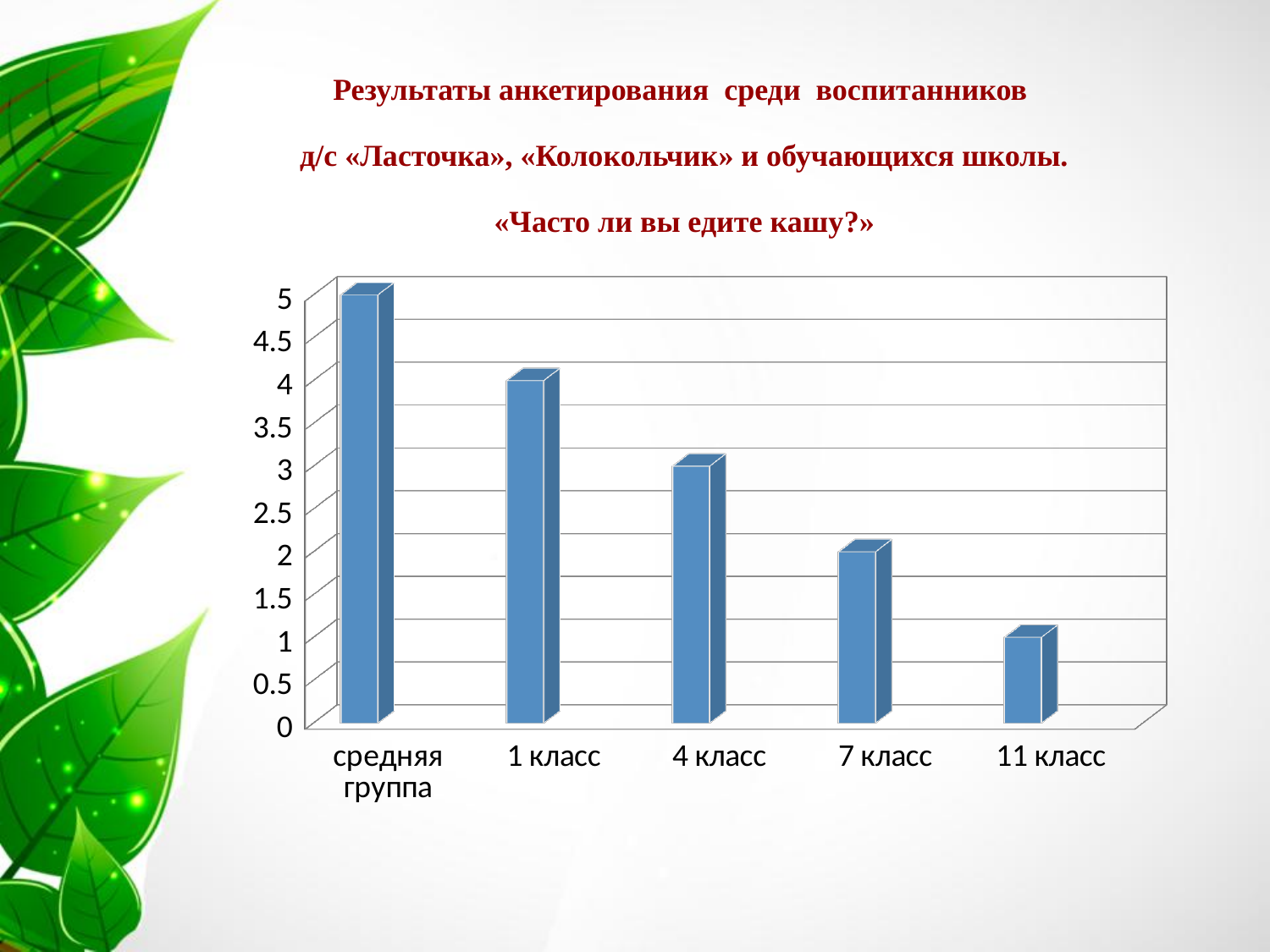
Which is larger, the value for 1 класс or the value for 7 класс? 1 класс How many categories are shown on the x axis of the chart? 5 What is the value for средняя группа? 5 Which category has the highest bar in the chart? средняя группа What kind of chart is shown on the slide? bar chart What is the difference between the value for средняя группа and the value for 11 класс? 4 What is the value for 11 класс? 1 Do the values rise or fall moving from left to right along the x axis? fall Which category has the lowest bar in the chart? 11 класс What is the value for 4 класс? 3 What is the value for 1 класс? 4 What is the value for 7 класс? 2